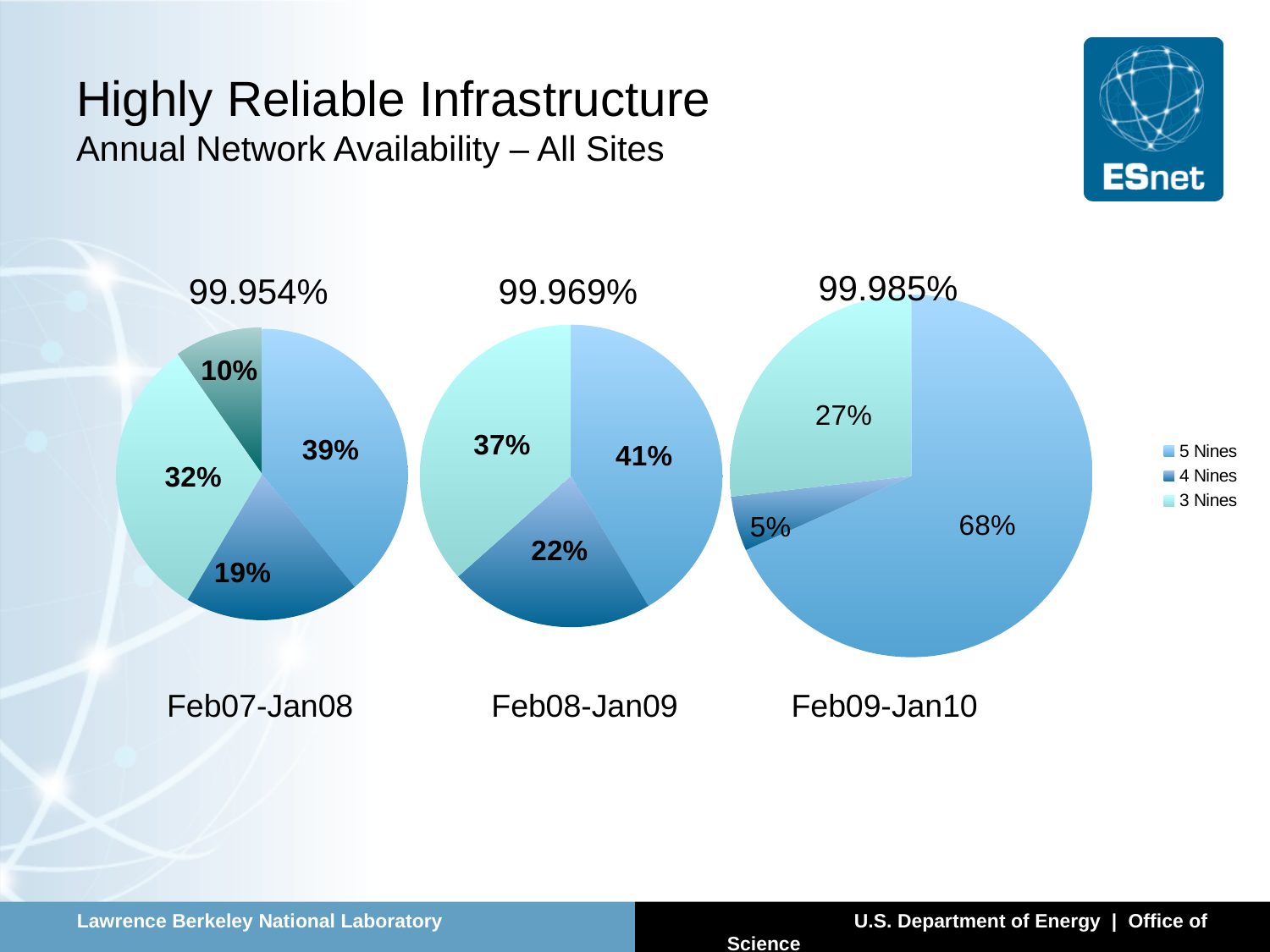
In the Feb09-Jan10 pie chart, what share is labelled for 5 Nines? 68% In the Feb09-Jan10 pie chart, which legend category has the smallest slice? 4 Nines How many pie charts are shown on the slide? 3 How many categories does the legend list? 3 In the Feb07-Jan08 pie chart, what share is labelled for 3 Nines? 32% In the Feb08-Jan09 pie chart, what share is labelled for 4 Nines? 22% In the Feb07-Jan08 pie chart, which is larger: the 5 Nines slice or the 4 Nines slice? 5 Nines What kind of chart is used for the Feb08-Jan09 data? Pie chart In the Feb08-Jan09 pie chart, what is the difference between the 5 Nines share and the 3 Nines share? 4% Does the 5 Nines share rise or fall from Feb07-Jan08 to Feb09-Jan10 across the three pie charts? Rise In the Feb09-Jan10 pie chart, which legend category has the largest slice? 5 Nines What annual availability percentage is printed above the Feb09-Jan10 pie chart? 99.985%